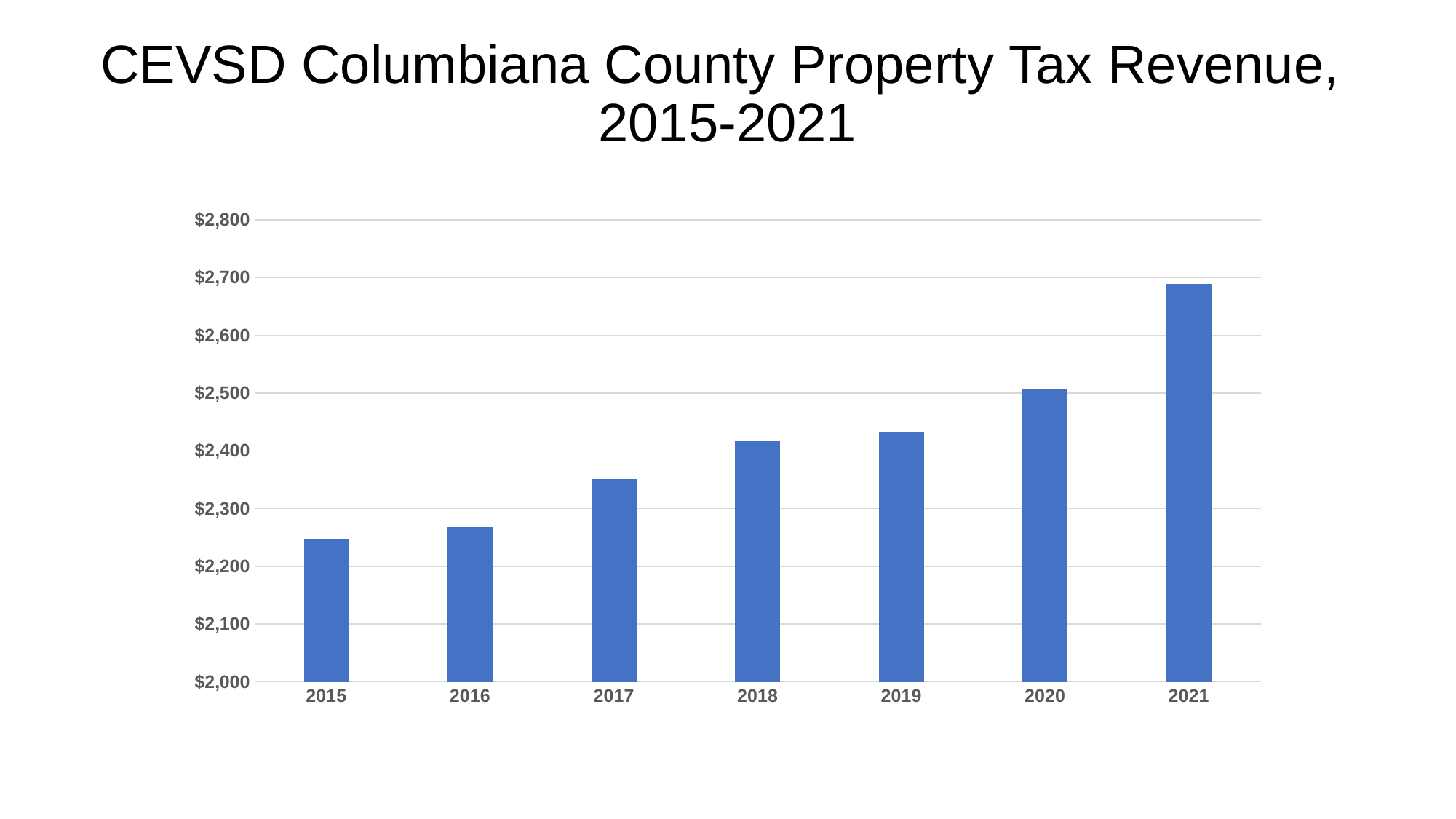
How many years are plotted on the chart? 7 Is the value for 2021 greater or less than $2,600? greater Is the value for 2015 greater or less than $2,300? less Is the value for 2019 greater or less than $2,500? less Which year has the lowest property tax revenue? 2015 What is the title of the chart? CEVSD Columbiana County Property Tax Revenue, 2015-2021 Which is larger, the value for 2020 or the value for 2021? 2021 Do the values rise or fall from 2015 to 2021? rise What kind of chart is shown on the slide? bar chart Which year has the highest property tax revenue? 2021